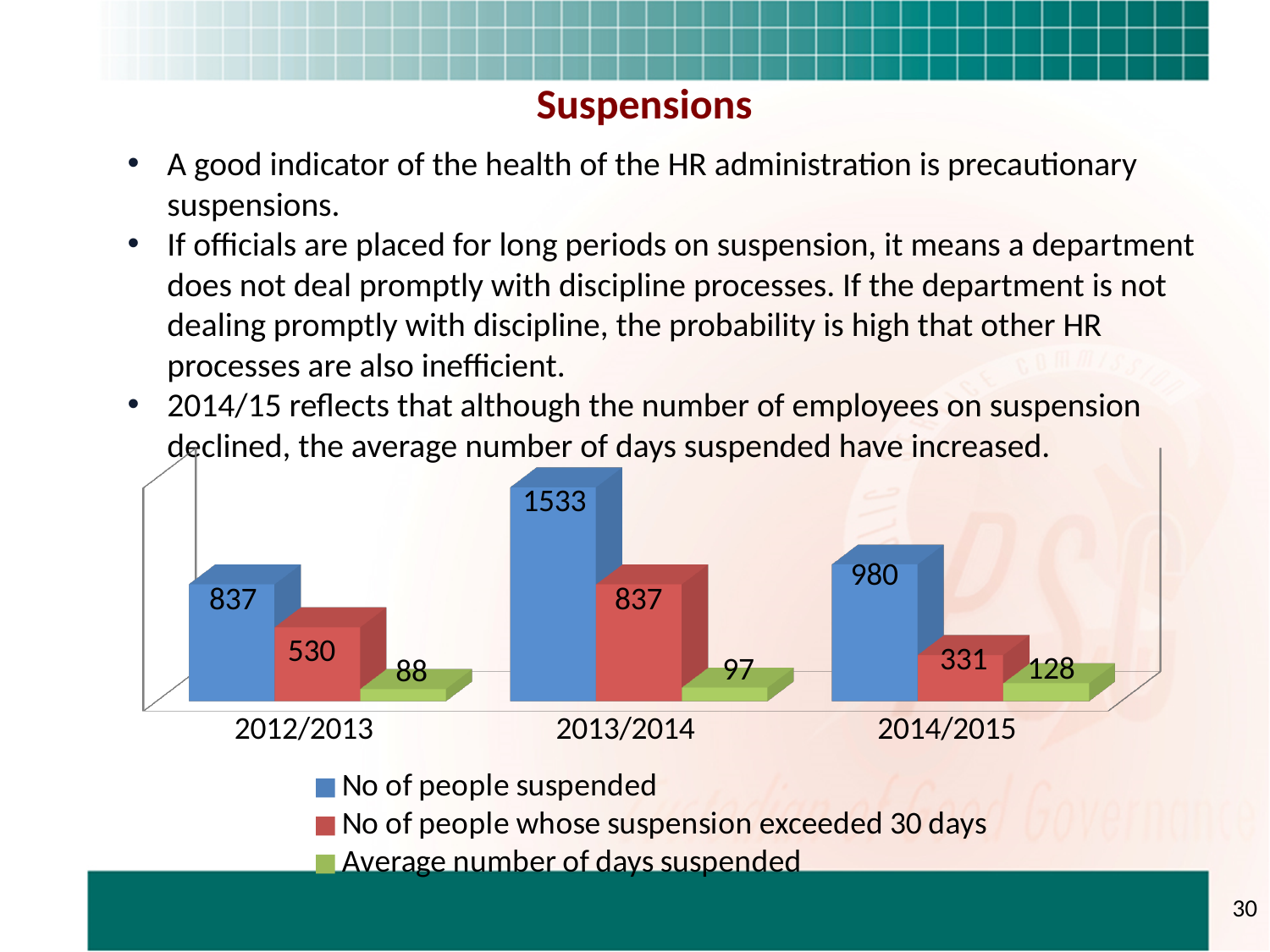
Does the average number of days suspended rise or fall from 2012/2013 to 2014/2015? Rise How many year categories are shown on the x axis? 3 How many series does the legend list? 3 Which colour represents the 'Average number of days suspended' series? Green Which year has the lowest average number of days suspended? 2012/2013 What is the number of people whose suspension exceeded 30 days in 2014/2015? 331 Which is larger: the number of people whose suspension exceeded 30 days in 2012/2013 or in 2014/2015? 2012/2013 Which year has the highest number of people suspended? 2013/2014 What is the difference between the number of people suspended in 2013/2014 and in 2014/2015? 553 What is the number of people suspended in 2013/2014? 1533 What kind of chart is shown on the slide? Bar chart What is the average number of days suspended in 2012/2013? 88